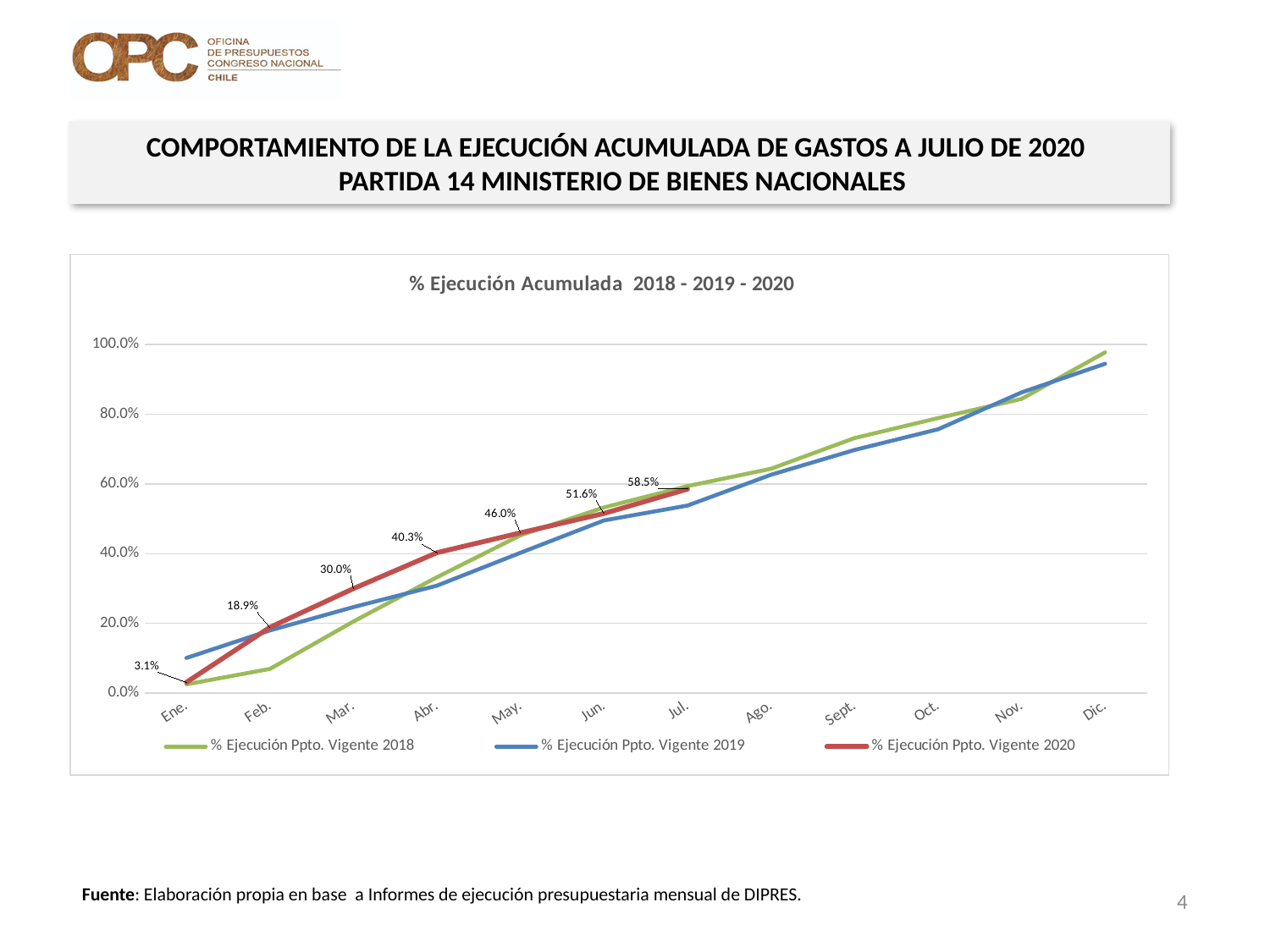
What type of chart is shown on the slide? line chart What is the value for % Ejecución Ppto. Vigente 2020 in Abr.? 40.3% How many months are shown on the x axis? 12 What is the difference between the 2020 values for Mar. and Feb.? 11.1% What is the value for % Ejecución Ppto. Vigente 2020 in Ene.? 3.1% What is the value for % Ejecución Ppto. Vigente 2020 in Jul.? 58.5% In Mar., which series has the larger value: % Ejecución Ppto. Vigente 2020 or % Ejecución Ppto. Vigente 2018? % Ejecución Ppto. Vigente 2020 What is the difference between the 2020 values for Jul. and Jun.? 6.9% Is the value for % Ejecución Ppto. Vigente 2018 in Dic. greater or less than 80.0%? greater How many series does the legend list? 3 Does the % Ejecución Ppto. Vigente 2020 series rise or fall from Ene. to Jul.? rise What is the chart's title? % Ejecución Acumulada 2018 - 2019 - 2020